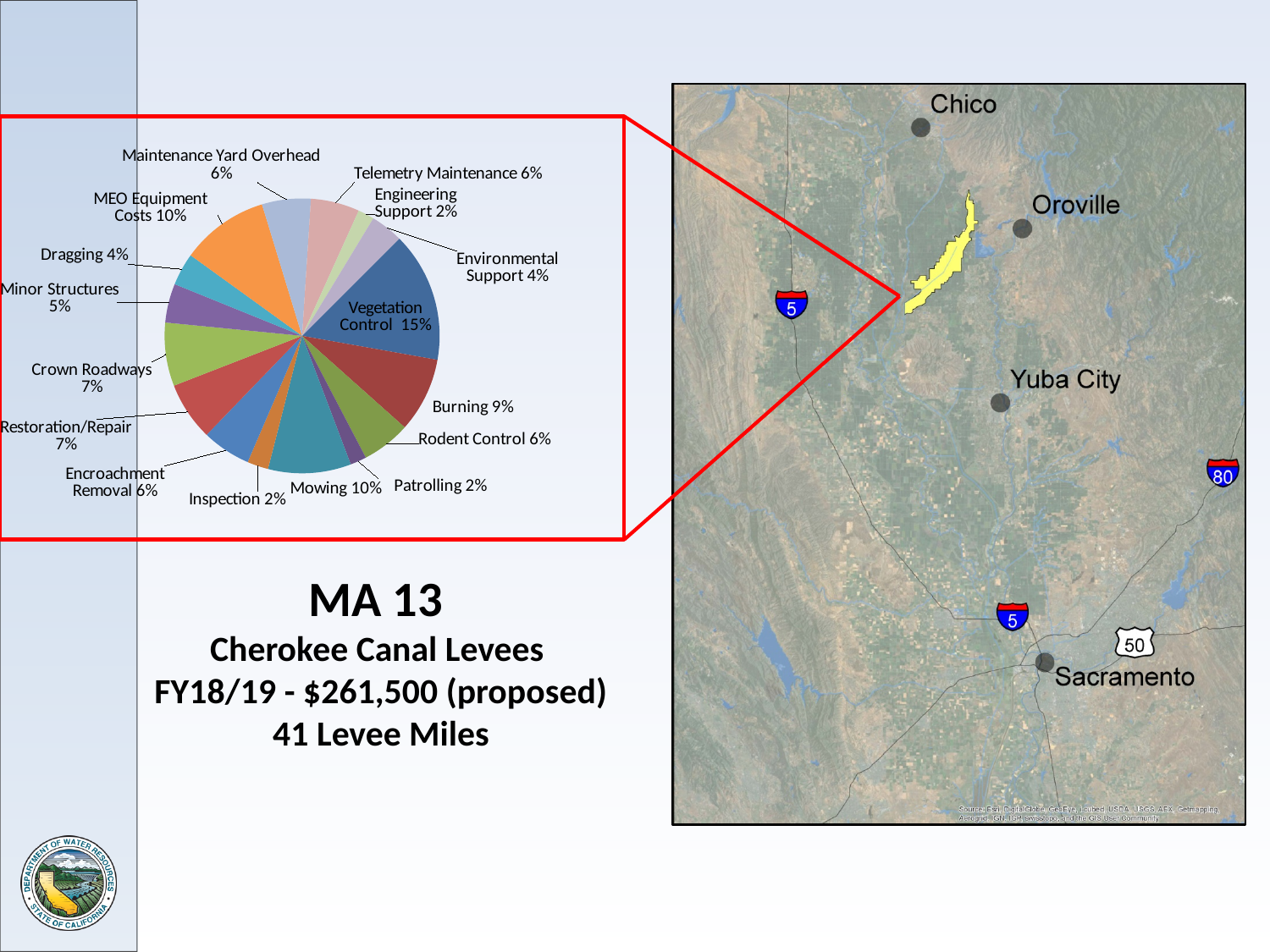
What percentage is shown for Crown Roadways? 7% What percentage is shown for Minor Structures? 5% What percentage is shown for MEO Equipment Costs? 10% What percentage is shown for Burning? 9% Which category has the largest share of the pie? Vegetation Control What percentage is shown for Mowing? 10% Which maintenance area and levee system does the slide say the chart is for? MA 13 Cherokee Canal Levees Which is larger, the share for Vegetation Control or the share for Mowing? Vegetation Control What kind of chart is shown on the slide? pie chart What is the difference between the Vegetation Control share and the Burning share? 6% How many categories are shown in the pie chart? 16 What share of the pie does Vegetation Control represent? 15%